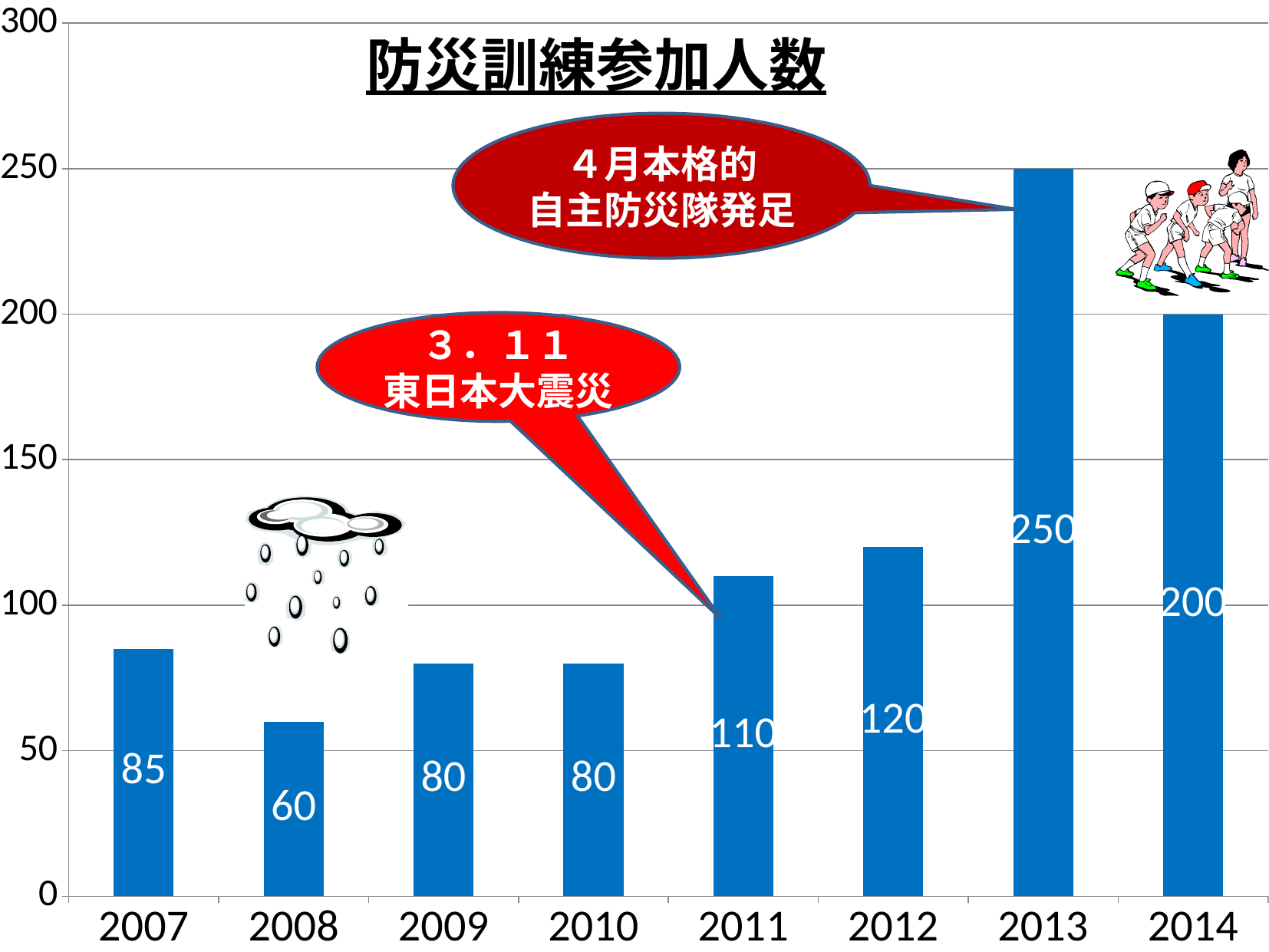
What is the difference between the values for 2013 and 2014? 50 Is the value for 2013 greater or less than 200? greater What is the value for 2008? 60 What kind of chart is shown on the slide? bar chart What is the value for 2014? 200 What is the title of the chart? 防災訓練参加人数 Which year has the highest value? 2013 What is the difference between the values for 2007 and 2008? 25 Which is larger, the value for 2012 or the value for 2011? 2012 What is the value for 2011? 110 How many years are shown on the x axis? 8 Which year has the lowest value? 2008